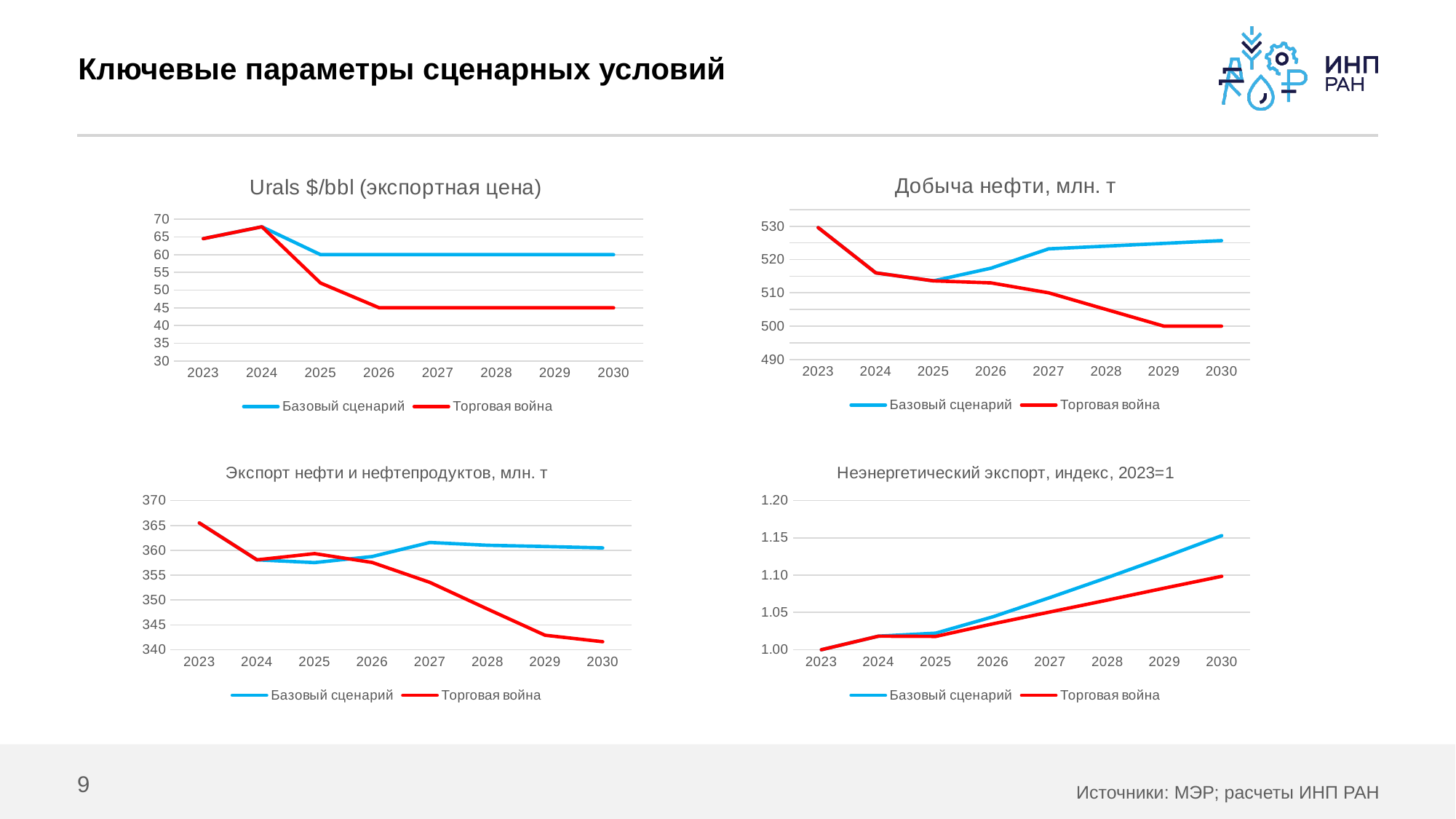
In the 'Экспорт нефти и нефтепродуктов, млн. т' chart, in which year is the 'Торговая война' series highest? 2023 In the 'Urals $/bbl (экспортная цена)' chart, what is the difference between 'Базовый сценарий' and 'Торговая война' in 2030? 15 In the 'Urals $/bbl (экспортная цена)' chart, what is the value of 'Торговая война' in 2030? 45 In the 'Добыча нефти, млн. т' chart, what is the value of 'Торговая война' in 2030? 500 In the 'Urals $/bbl (экспортная цена)' chart, what is the value of 'Базовый сценарий' in 2030? 60 In the 'Неэнергетический экспорт, индекс, 2023=1' chart, does the 'Базовый сценарий' line rise or fall from 2023 to 2030? rise How many series does the legend of the 'Добыча нефти, млн. т' chart list? 2 How many years are shown on the x axis of the 'Экспорт нефти и нефтепродуктов, млн. т' chart? 8 What kind of chart is the 'Urals $/bbl (экспортная цена)' chart? line chart In the 'Экспорт нефти и нефтепродуктов, млн. т' chart, which series is higher in 2030, 'Базовый сценарий' or 'Торговая война'? Базовый сценарий In the 'Неэнергетический экспорт, индекс, 2023=1' chart, is the value for 'Базовый сценарий' in 2030 greater or less than 1.10? greater In the 'Добыча нефти, млн. т' chart, is the value for 'Базовый сценарий' in 2030 greater or less than 520? greater